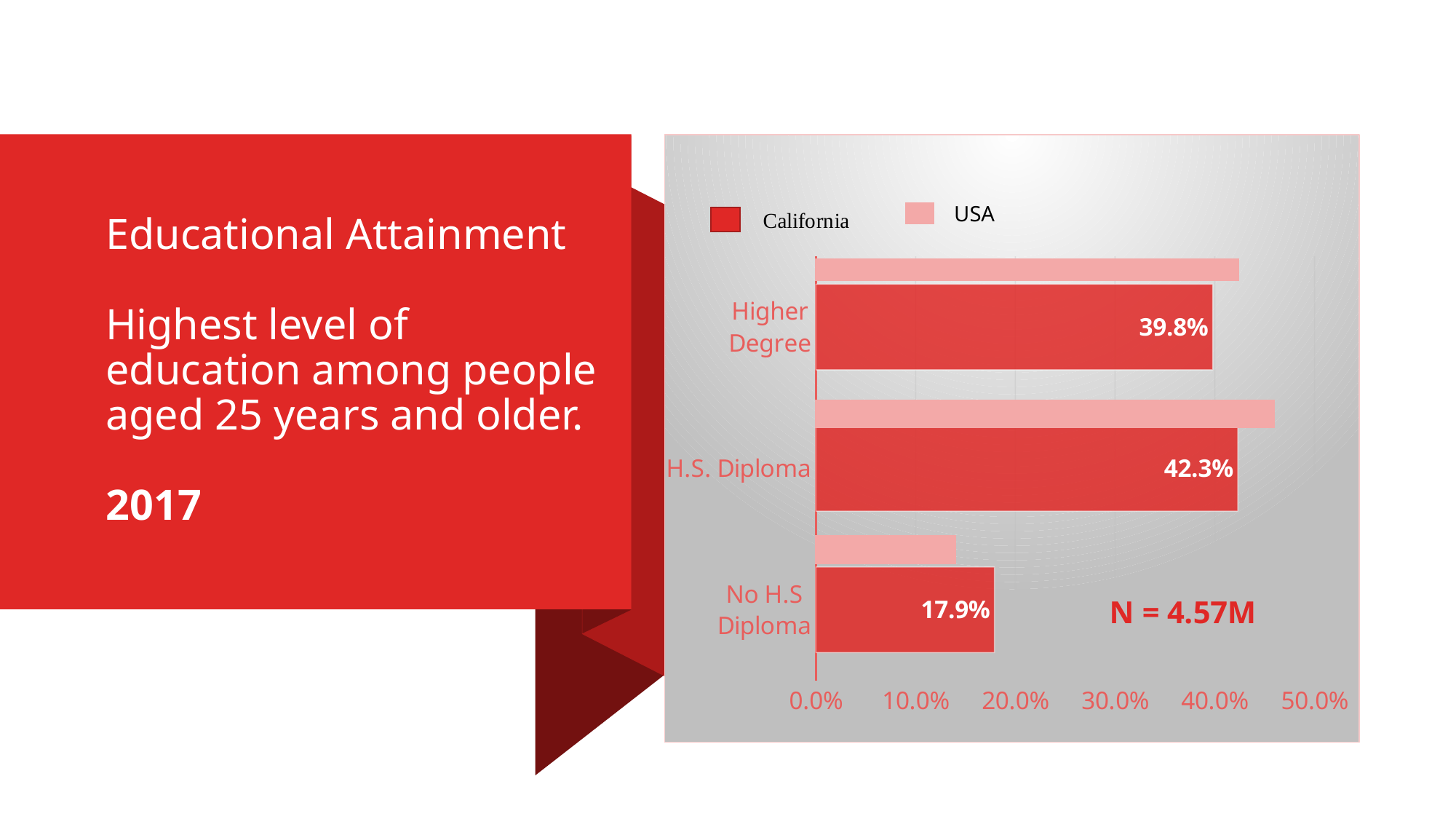
What is the California value for Higher Degree? 39.8% Is the USA value for No H.S Diploma greater or less than 20.0%? less What kind of chart is shown on the slide? Bar chart Which category has the highest California value? H.S. Diploma How many series does the legend list? 2 For No H.S Diploma, which series has the larger value, California or USA? California What is the California value for H.S. Diploma? 42.3% For Higher Degree, which series has the larger value, California or USA? USA Is the USA value for H.S. Diploma greater or less than 40.0%? greater Which category has the lowest California value? No H.S Diploma What is the difference between the California values for H.S. Diploma and Higher Degree? 2.5% What is the California value for No H.S Diploma? 17.9%